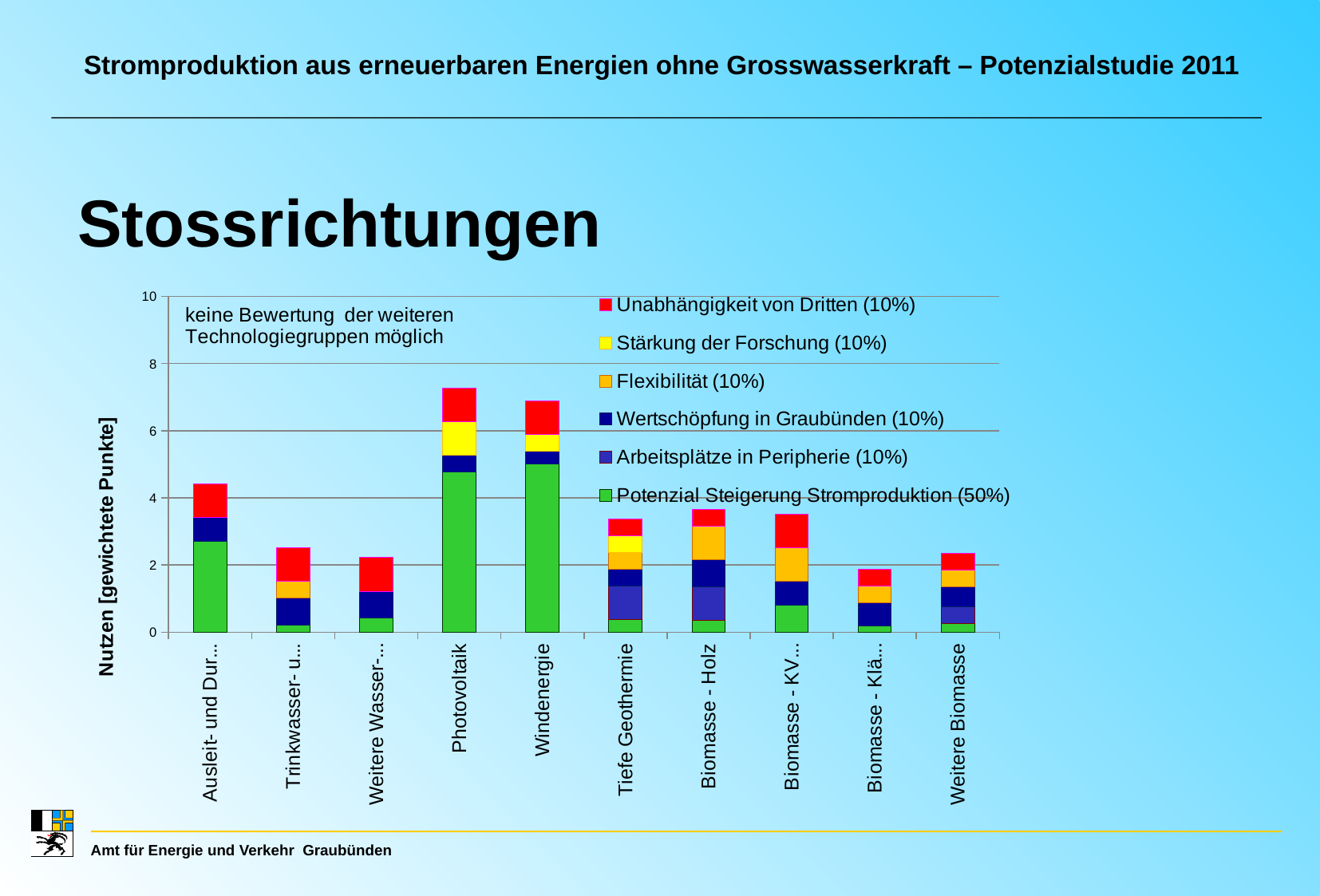
Is the total value for Biomasse - Holz greater or less than 2? greater What is the label of the chart's y axis? Nutzen [gewichtete Punkte] Which category has the highest total stacked bar? Photovoltaik Which has the larger total bar, Photovoltaik or Tiefe Geothermie? Photovoltaik Which has the larger total bar, Biomasse - Holz or Weitere Biomasse? Biomasse - Holz Is the total value for Photovoltaik greater or less than 6? greater Is the total value for Windenergie greater or less than 6? greater How many categories (technology groups) are shown on the x axis of the chart? 10 How many series does the chart's legend list? 6 Which legend entry carries a weight of 50%? Potenzial Steigerung Stromproduktion (50%) What kind of chart is shown on the slide? Stacked bar chart